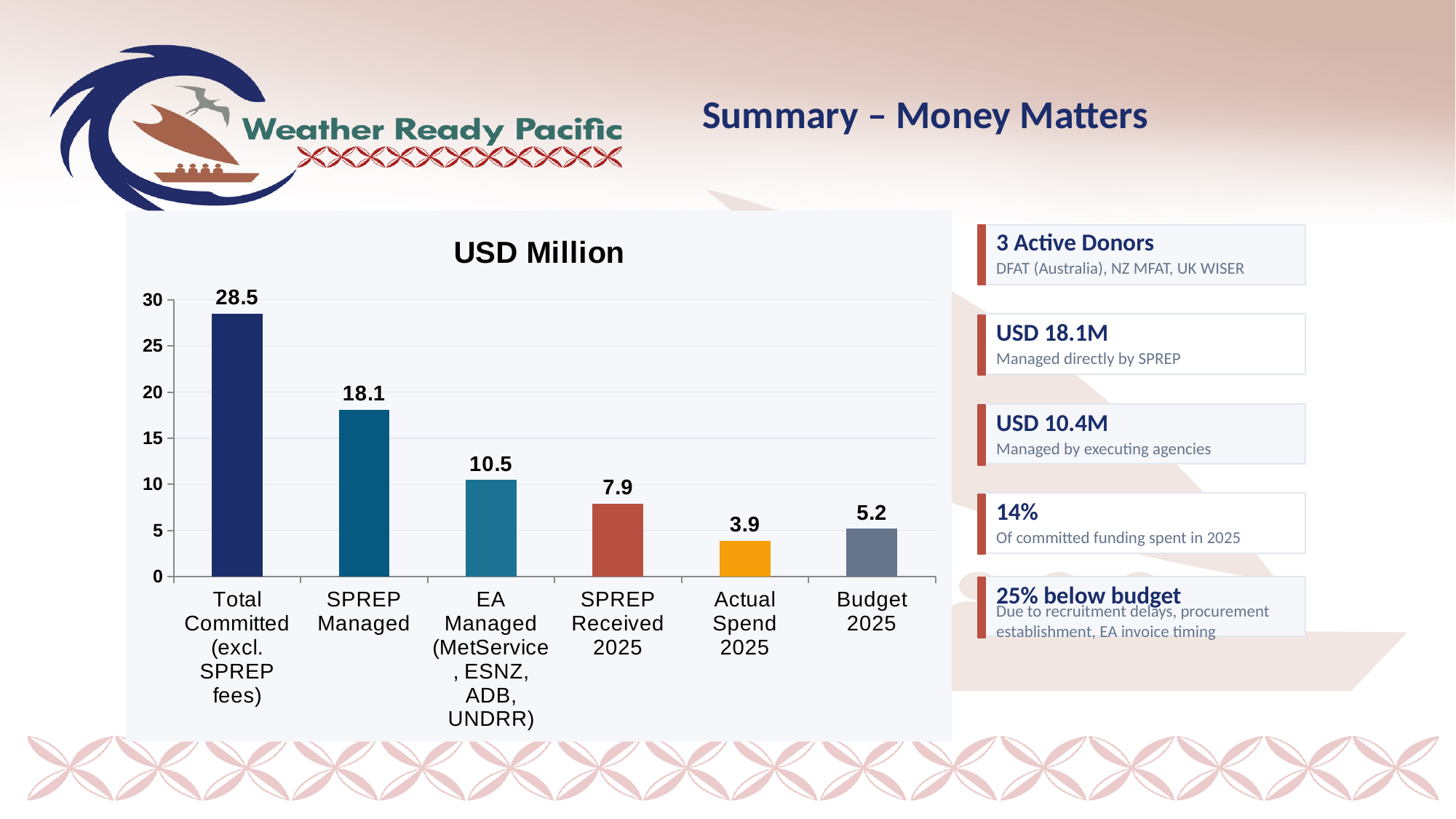
What is the value for EA Managed (MetService, ESNZ, ADB, UNDRR)? 10.5 What is the title of the chart? USD Million How many categories are shown in the chart? 6 What is the value for Total Committed (excl. SPREP fees)? 28.5 Which category has the highest value? Total Committed (excl. SPREP fees) Which category has the lowest value? Actual Spend 2025 What is the value for Actual Spend 2025? 3.9 What kind of chart is shown on the slide? Bar chart Which is larger, SPREP Managed or EA Managed? SPREP Managed What is the value for SPREP Received 2025? 7.9 What is the value for SPREP Managed? 18.1 What is the difference between Budget 2025 and Actual Spend 2025? 1.3